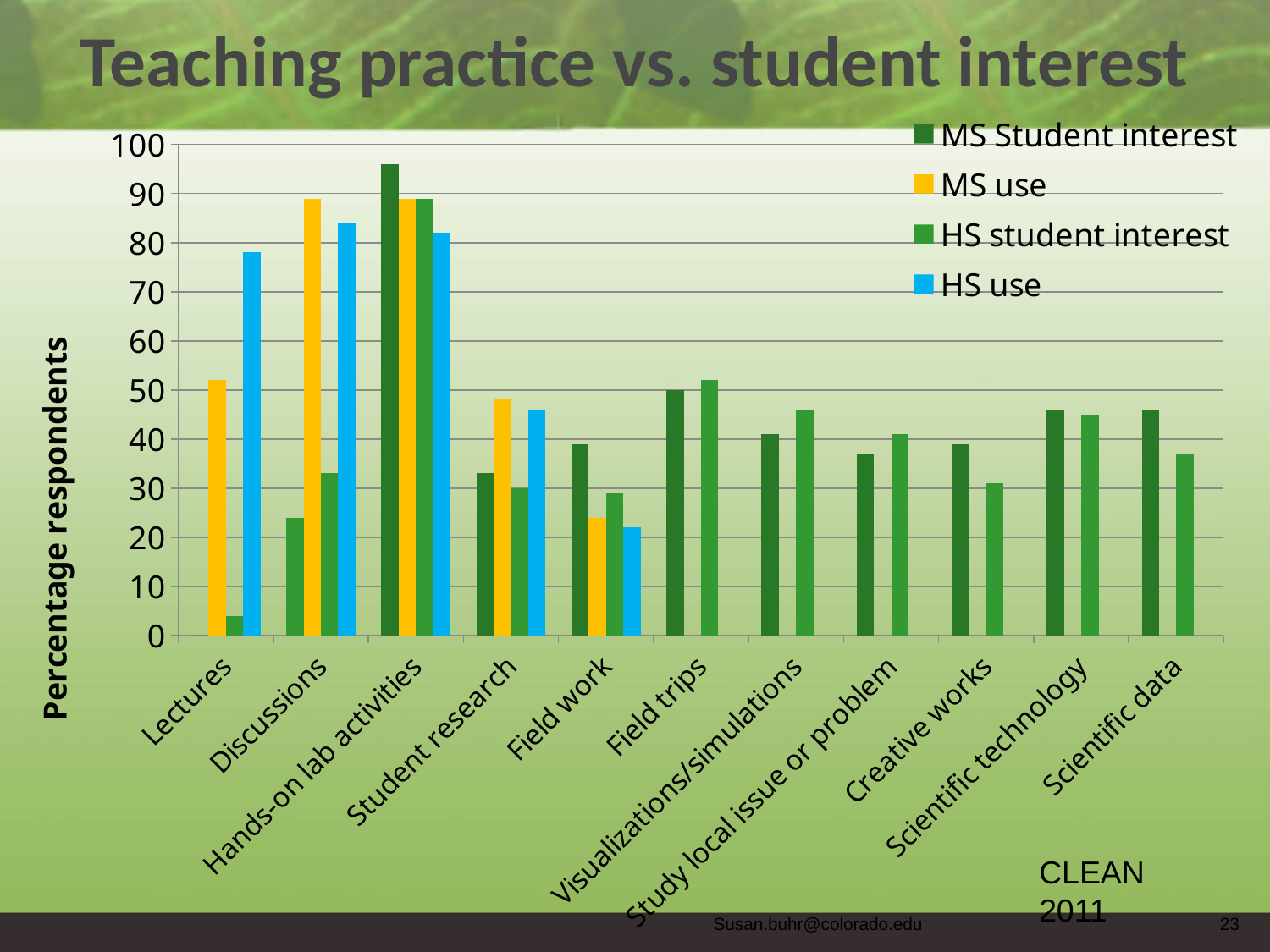
Is the HS use value for Field work greater or less than 30? less Is the HS student interest value for Lectures greater or less than 10? less How many categories are shown on the x axis? 11 Is the MS Student interest value for Hands-on lab activities greater or less than 90? greater How many series does the legend list? 4 Which category has the lowest HS student interest value? Lectures What is the label on the vertical axis? Percentage respondents Which category has the highest MS Student interest value? Hands-on lab activities What kind of chart is shown on the slide? bar chart For Field work, which is larger: MS Student interest or HS student interest? MS Student interest What is the title of the chart? Teaching practice vs. student interest